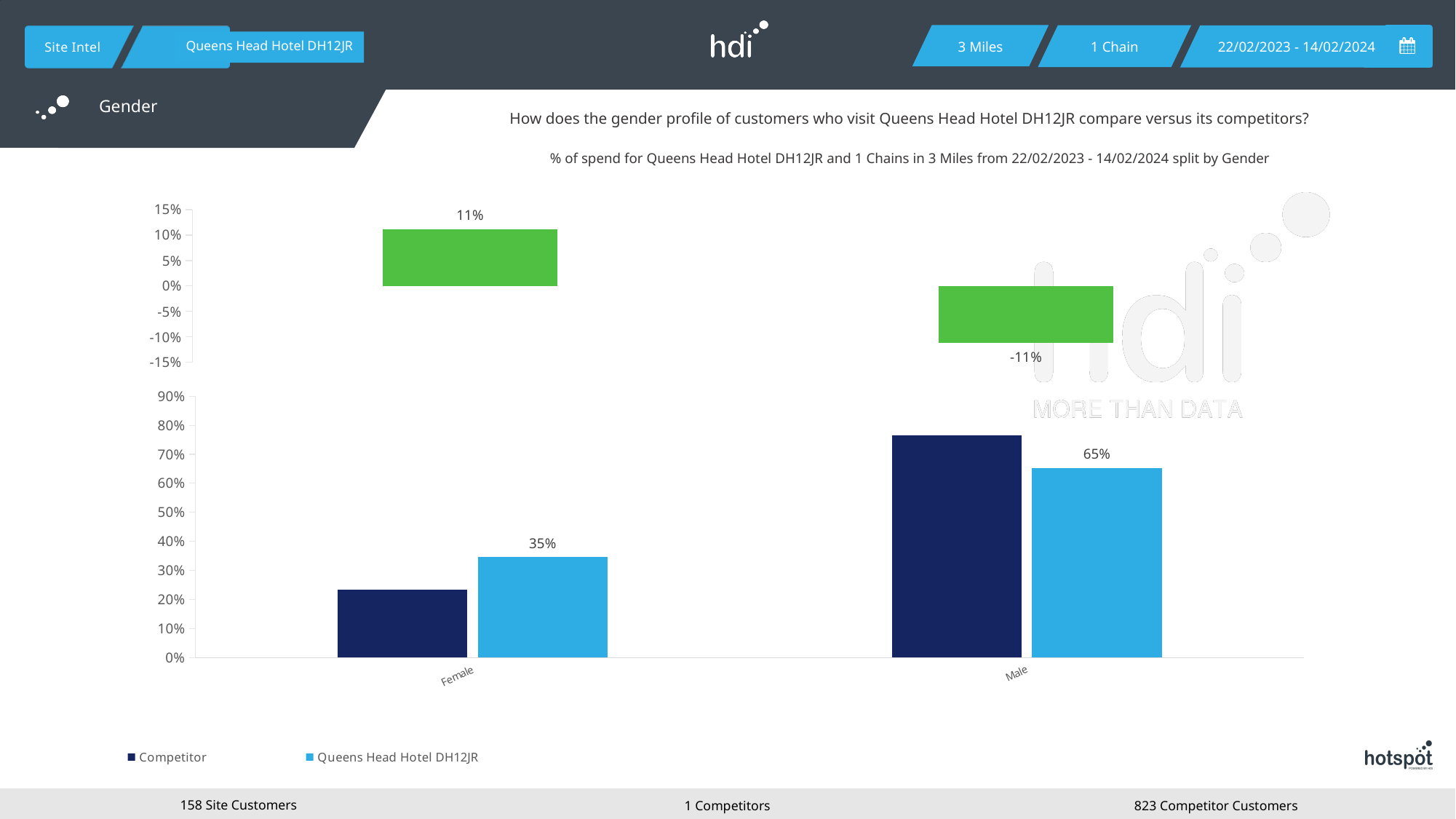
In the bottom chart, what is the difference between the Queens Head Hotel DH12JR values for Male and Female? 30% What kind of chart is the bottom chart? bar chart In the top chart, what is the value shown for Male? -11% In the top chart, what is the value shown for Female? 11% In the bottom chart, what is the value for Queens Head Hotel DH12JR for Female? 35% In the bottom chart, which is larger for Female: Competitor or Queens Head Hotel DH12JR? Queens Head Hotel DH12JR How many series does the legend of the bottom chart list? 2 In the bottom chart, is the Competitor value for Female greater or less than 30%? less In the bottom chart, is the Competitor value for Male greater or less than 70%? greater In the bottom chart, what is the value for Queens Head Hotel DH12JR for Male? 65% How many categories are shown on the x axis of the bottom chart? 2 In the bottom chart, which is larger for Male: Competitor or Queens Head Hotel DH12JR? Competitor